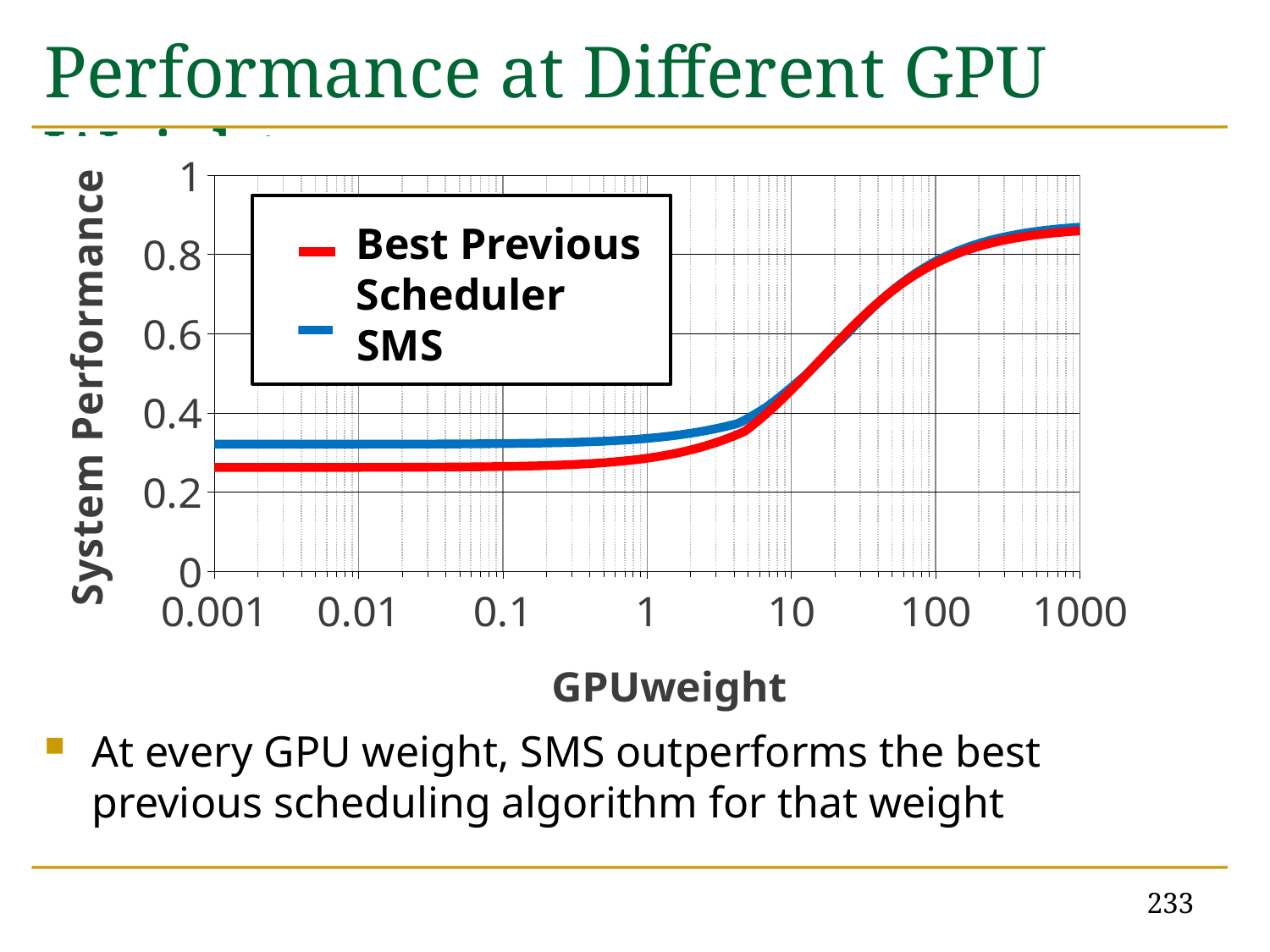
Is the System Performance of Best Previous Scheduler at a GPU weight of 10 greater or less than 0.6? less Is the System Performance of SMS at a GPU weight of 1000 greater or less than 0.8? greater Is the System Performance of Best Previous Scheduler at a GPU weight of 0.001 greater or less than 0.2? greater Do the System Performance values for Best Previous Scheduler rise or fall as GPU weight increases along the x axis? rise What is the title of the x axis? GPUweight At a GPU weight of 0.001, which series has the higher System Performance, SMS or Best Previous Scheduler? SMS Which series is plotted in red? Best Previous Scheduler Do the System Performance values for SMS rise or fall as GPU weight increases along the x axis? rise How many series does the legend list? 2 What kind of chart is shown on the slide? line chart At a GPU weight of 1, which series has the higher System Performance, SMS or Best Previous Scheduler? SMS